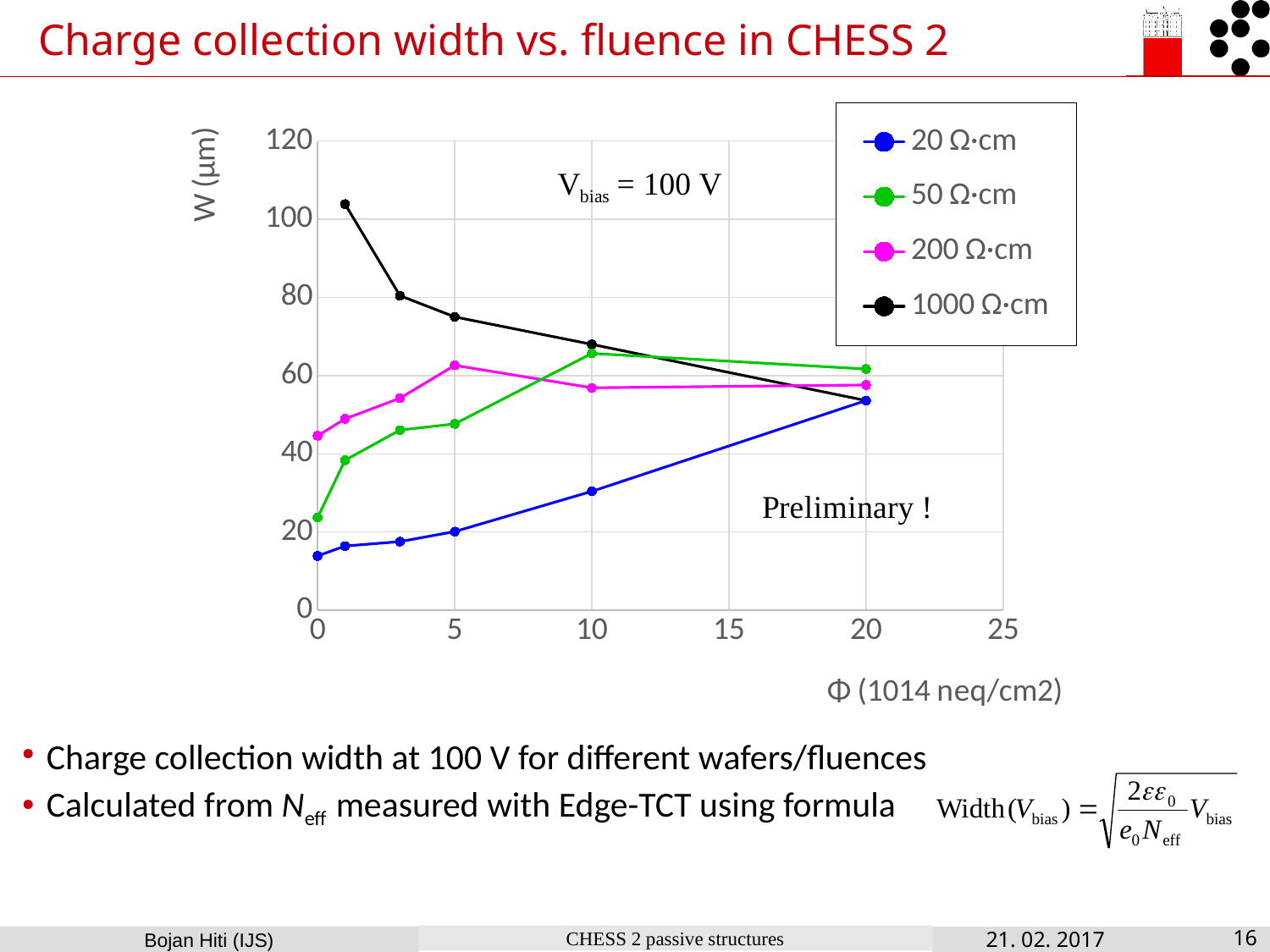
Which series is plotted in black? 1000 Ω·cm What kind of chart is shown on the slide? line chart Does the charge collection width for 1000 Ω·cm rise or fall as fluence increases? fall Which series has the lowest width at a fluence of 0? 20 Ω·cm How many series does the legend list? 4 Is the width for 20 Ω·cm at a fluence of 10 greater or less than 40 µm? less How many data points are plotted for the 1000 Ω·cm series? 5 Is the width for 1000 Ω·cm at a fluence of 1 greater or less than 100 µm? less What is the label of the y axis? W (µm) Which series has the highest width at a fluence of 1 (×10^14 neq/cm2)? 1000 Ω·cm Does the charge collection width for 20 Ω·cm rise or fall as fluence increases? rise At a fluence of 10, which has the larger width: 1000 Ω·cm or 20 Ω·cm? 1000 Ω·cm